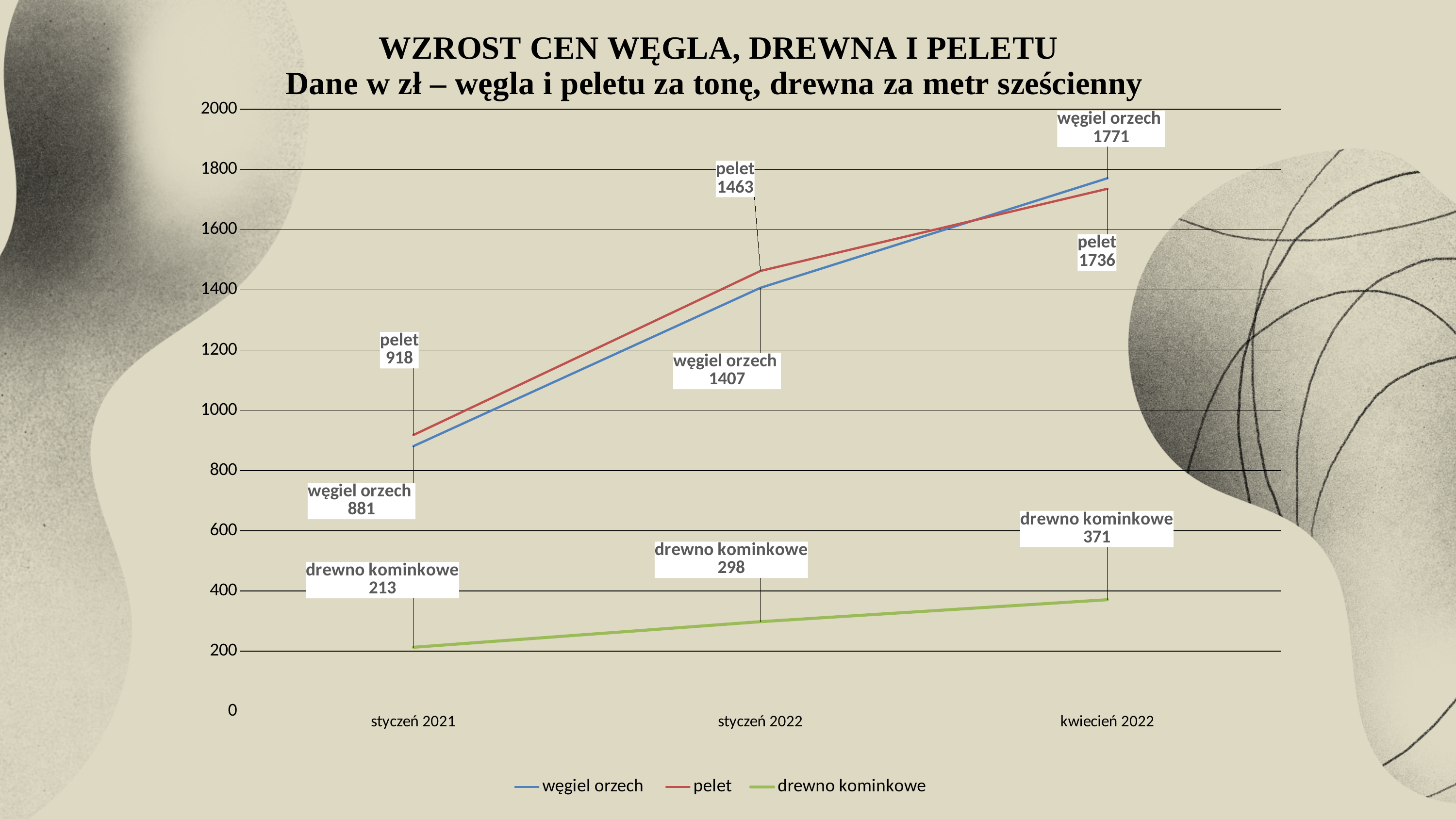
What is the value for pelet in kwiecień 2022? 1736 What kind of chart is shown on the slide? line chart How many series does the legend list? 3 What is the value for drewno kominkowe in kwiecień 2022? 371 In which period is the value for drewno kominkowe lowest? styczeń 2021 What is the value for węgiel orzech in styczeń 2021? 881 What is the difference between the węgiel orzech values in kwiecień 2022 and styczeń 2021? 890 Does the value for pelet rise or fall from styczeń 2021 to kwiecień 2022? rise Which is larger in styczeń 2022: the value for pelet or the value for węgiel orzech? pelet How many periods are shown on the x axis? 3 In which period is the value for węgiel orzech highest? kwiecień 2022 What is the value for pelet in styczeń 2022? 1463